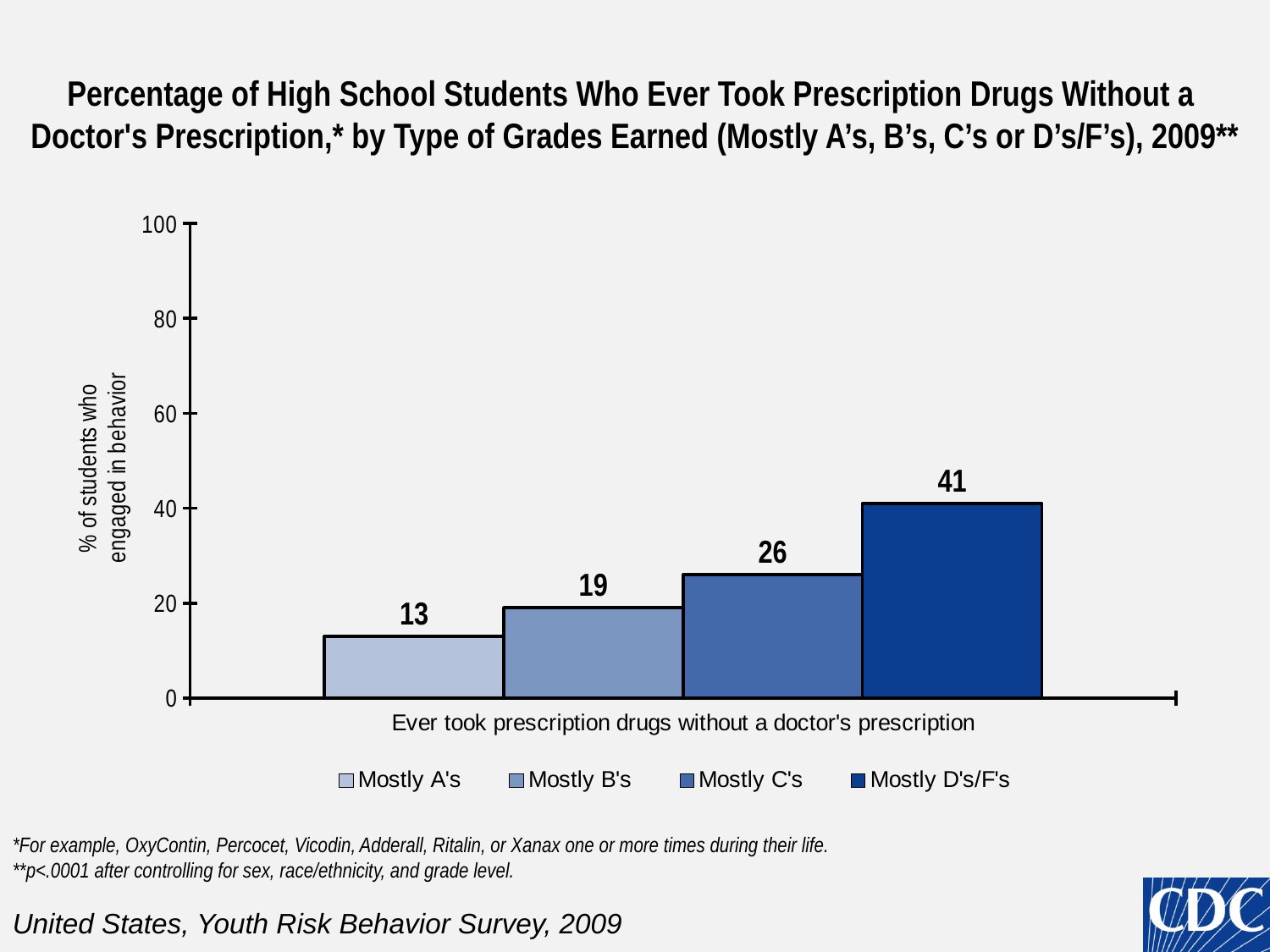
What percentage of students with Mostly A's ever took prescription drugs without a doctor's prescription? 13 How many series does the legend list? 4 Is the value for Mostly D's/F's greater or less than 40? greater What is the value for Mostly C's? 26 Which grade group has the highest percentage? Mostly D's/F's Which is larger, the value for Mostly B's or Mostly C's? Mostly C's Which grade group has the lowest percentage? Mostly A's What kind of chart is shown? Bar chart What is the value for Mostly B's? 19 Do the values rise or fall from Mostly A's to Mostly D's/F's? Rise What is the value for Mostly D's/F's? 41 What is the difference between the values for Mostly D's/F's and Mostly A's? 28